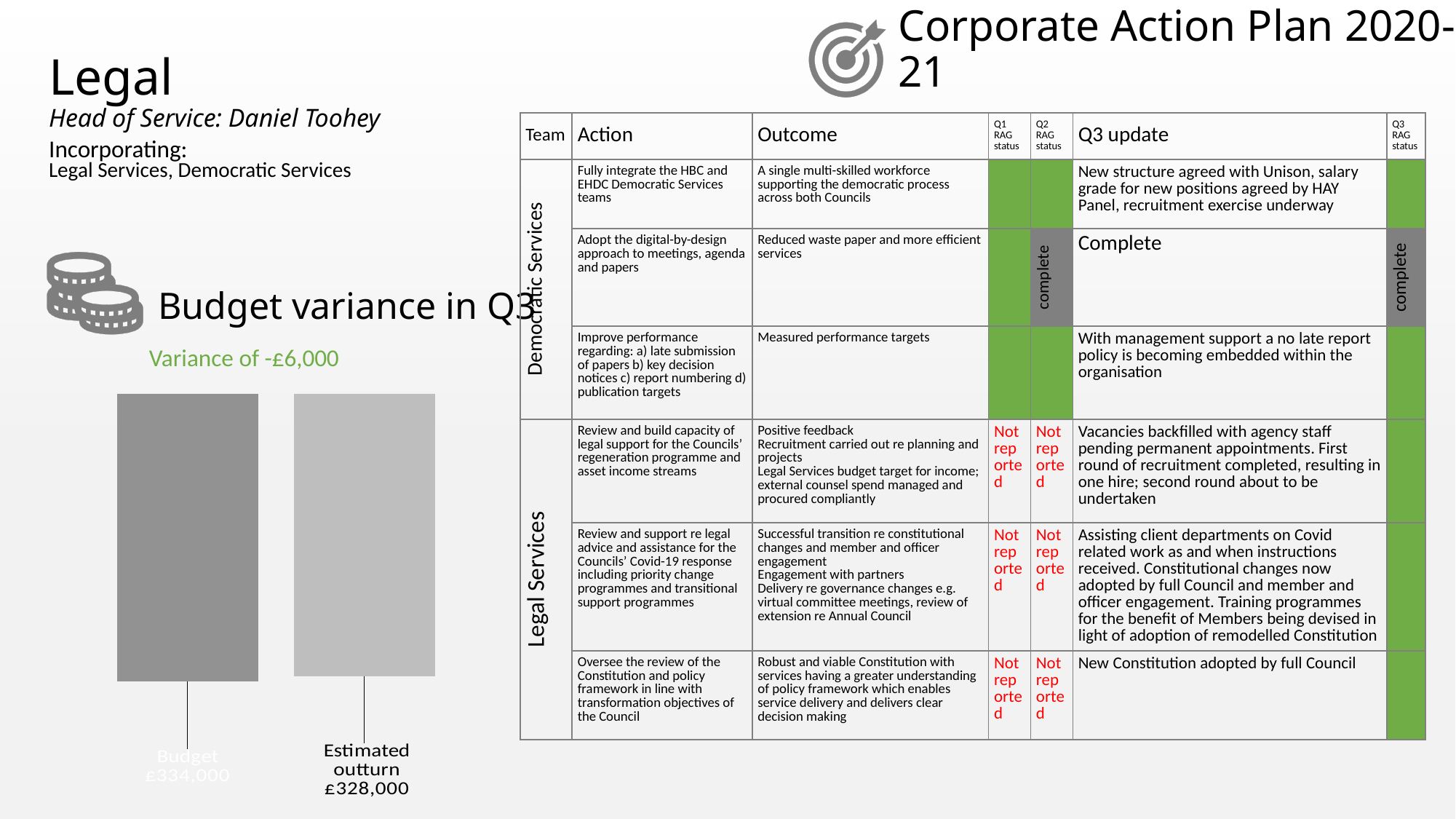
What kind of chart is used to show the budget variance in Q3? bar chart What is the value of the Estimated outturn bar in the budget variance chart? £328,000 What variance is stated above the budget variance chart? Variance of -£6,000 What is the value of the Budget bar in the budget variance chart? £334,000 Which bar in the budget variance chart is the lowest? Estimated outturn What is the difference between the Budget and the Estimated outturn in the budget variance chart? £6,000 Is the Budget value larger or smaller than the Estimated outturn value in the budget variance chart? larger What is the title of the chart on the left of the slide? Budget variance in Q3 How many bars are shown in the budget variance chart? 2 Which bar in the budget variance chart is higher, Budget or Estimated outturn? Budget